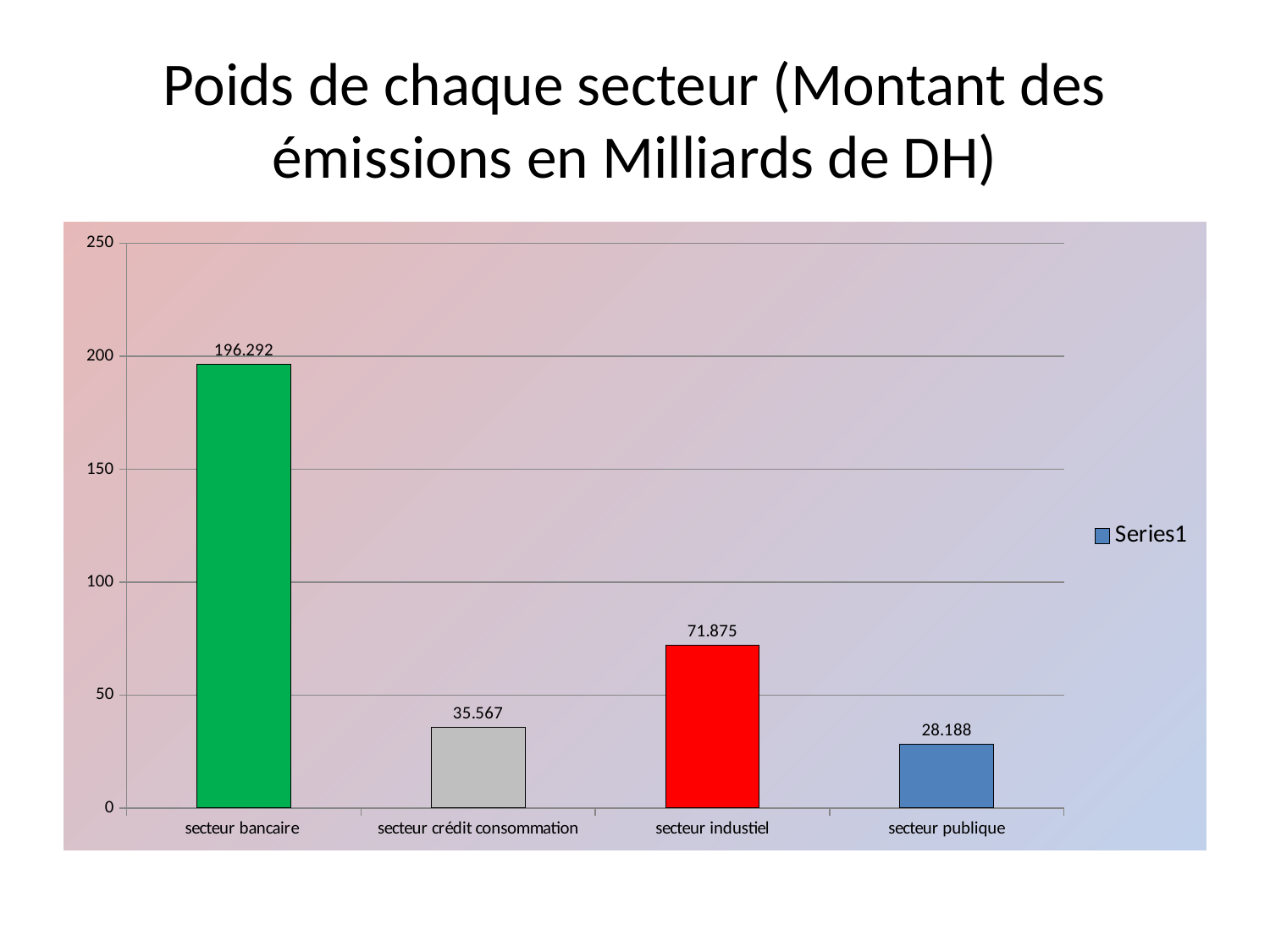
What is the value for secteur crédit consommation? 35.567 Which sector has the highest value? secteur bancaire How many sectors are shown on the chart? 4 What is the difference between the values for secteur bancaire and secteur industiel? 124.417 What is the value for secteur bancaire? 196.292 Which is larger, the value for secteur crédit consommation or the value for secteur industiel? secteur industiel Which sector has the lowest value? secteur publique Is the value for secteur bancaire greater or less than 150? greater What is the value for secteur publique? 28.188 What is the difference between the values for secteur industiel and secteur publique? 43.687 What kind of chart is shown on the slide? bar chart What is the value for secteur industiel? 71.875